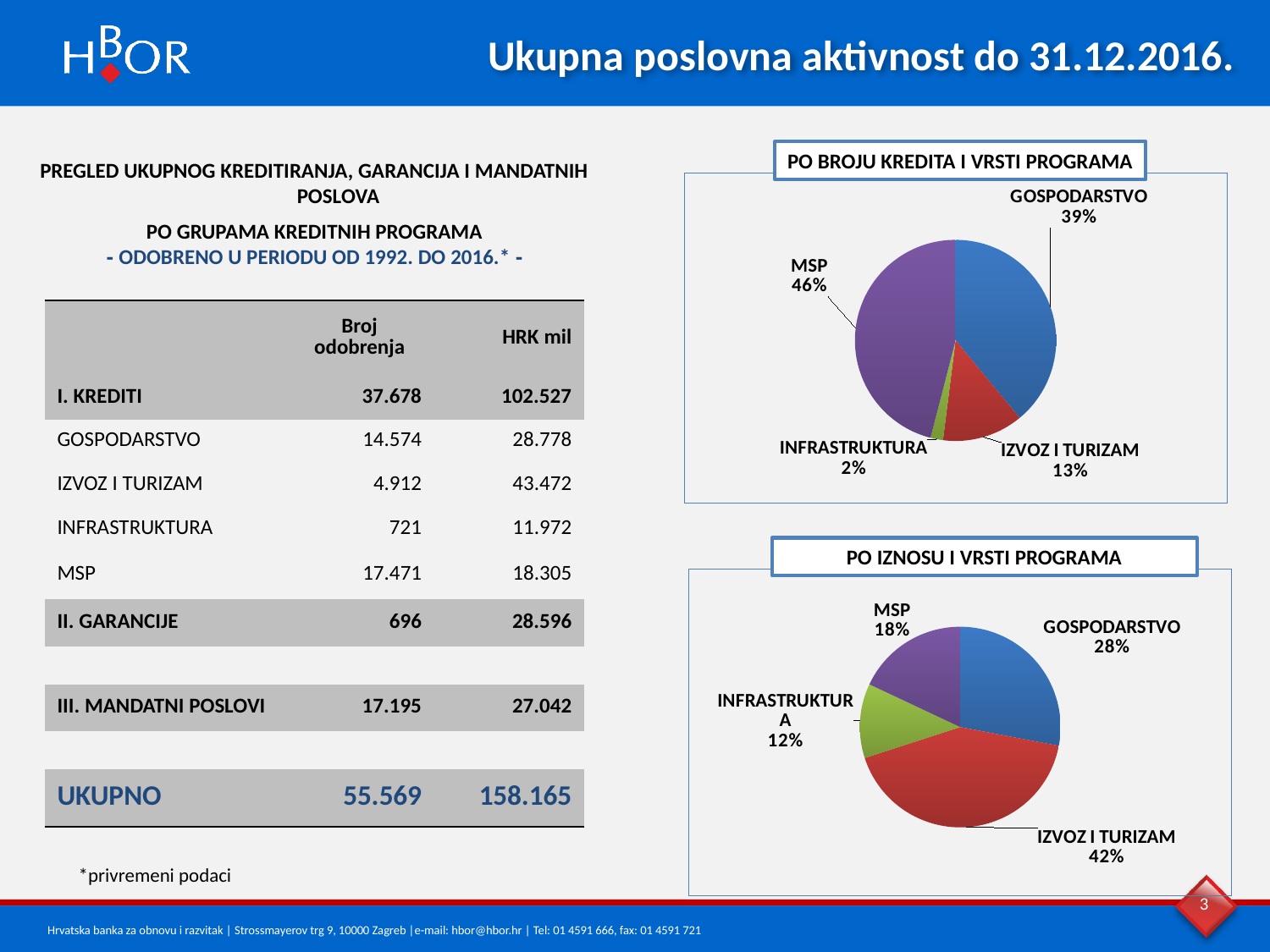
In the chart titled "PO BROJU KREDITA I VRSTI PROGRAMA", which category has the largest share? MSP In the chart titled "PO BROJU KREDITA I VRSTI PROGRAMA", what share does INFRASTRUKTURA have? 2% In the chart titled "PO BROJU KREDITA I VRSTI PROGRAMA", which category has the smallest share? INFRASTRUKTURA In the chart titled "PO BROJU KREDITA I VRSTI PROGRAMA", how many slices does the pie have? 4 In the chart titled "PO IZNOSU I VRSTI PROGRAMA", which is larger, MSP or INFRASTRUKTURA? MSP In the chart titled "PO IZNOSU I VRSTI PROGRAMA", what share does GOSPODARSTVO have? 28% In the chart titled "PO IZNOSU I VRSTI PROGRAMA", which category has the largest share? IZVOZ I TURIZAM In the chart titled "PO IZNOSU I VRSTI PROGRAMA", what share does IZVOZ I TURIZAM have? 42% In the chart titled "PO IZNOSU I VRSTI PROGRAMA", what is the difference in percentage points between IZVOZ I TURIZAM and MSP? 24 In the chart titled "PO BROJU KREDITA I VRSTI PROGRAMA", what is the difference in percentage points between GOSPODARSTVO and IZVOZ I TURIZAM? 26 What kind of chart is the one titled "PO IZNOSU I VRSTI PROGRAMA"? Pie chart